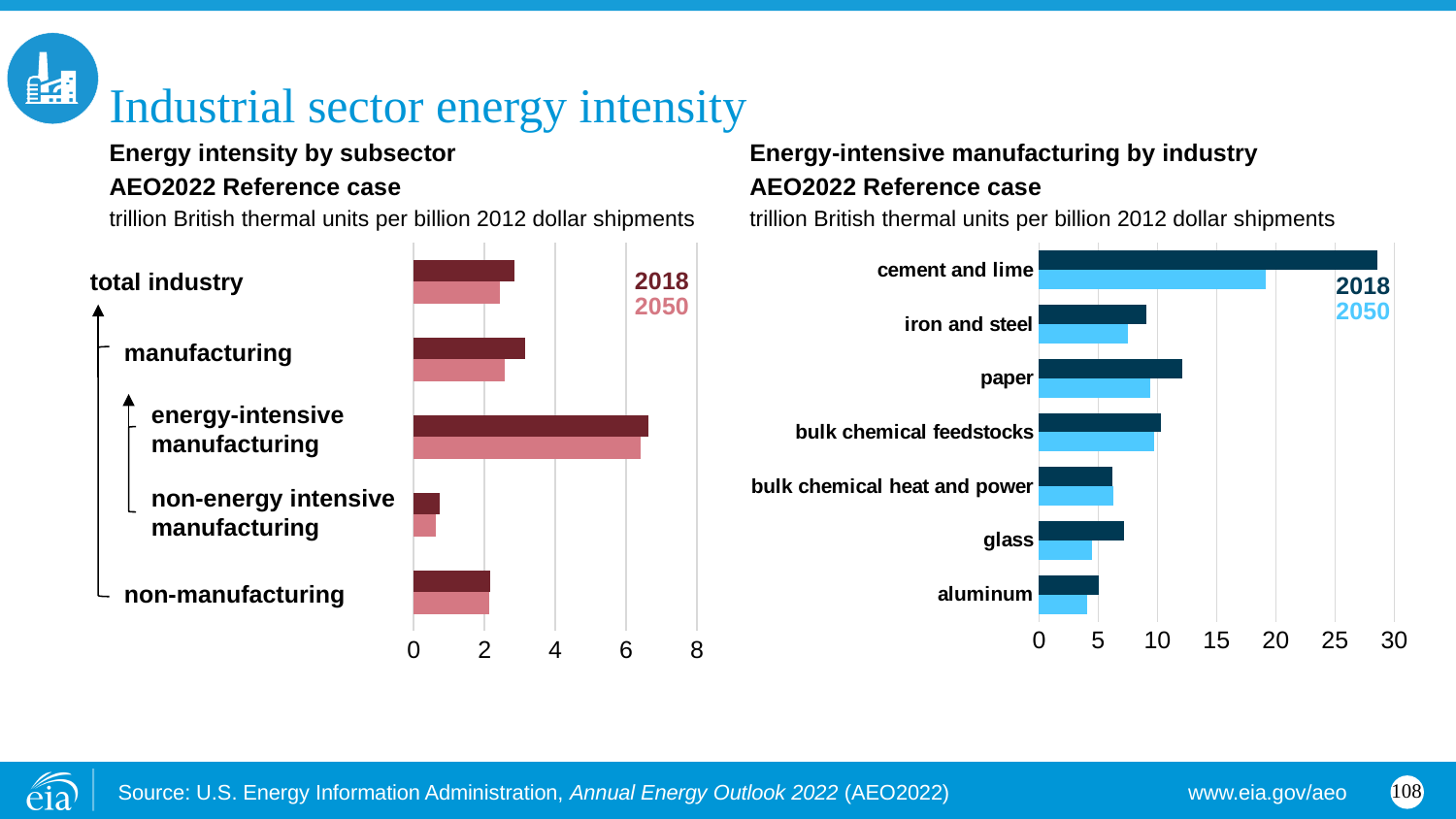
How many categories are shown in the 'Energy intensity by subsector' chart on the left? 5 In the 'Energy intensity by subsector' chart on the left, which category has the lowest energy intensity? non-energy intensive manufacturing In the 'Energy-intensive manufacturing by industry' chart on the right, which has the larger 2018 value: paper or iron and steel? paper In the 'Energy-intensive manufacturing by industry' chart on the right, is the 2018 value for cement and lime greater or less than 25? greater What are the two series shown in the legend of the 'Energy intensity by subsector' chart on the left? 2018 and 2050 In the 'Energy intensity by subsector' chart on the left, is the 2018 value for energy-intensive manufacturing greater or less than 6? greater In the 'Energy-intensive manufacturing by industry' chart on the right, which industry has the highest energy intensity? cement and lime How many series does the legend list in the 'Energy-intensive manufacturing by industry' chart on the right? 2 In the 'Energy-intensive manufacturing by industry' chart on the right, how many industries are shown? 7 What kind of chart is the 'Energy intensity by subsector' chart on the left? bar chart In the 'Energy intensity by subsector' chart on the left, is the 2018 value for non-energy intensive manufacturing greater or less than 2? less In the 'Energy intensity by subsector' chart on the left, which category has the highest energy intensity? energy-intensive manufacturing